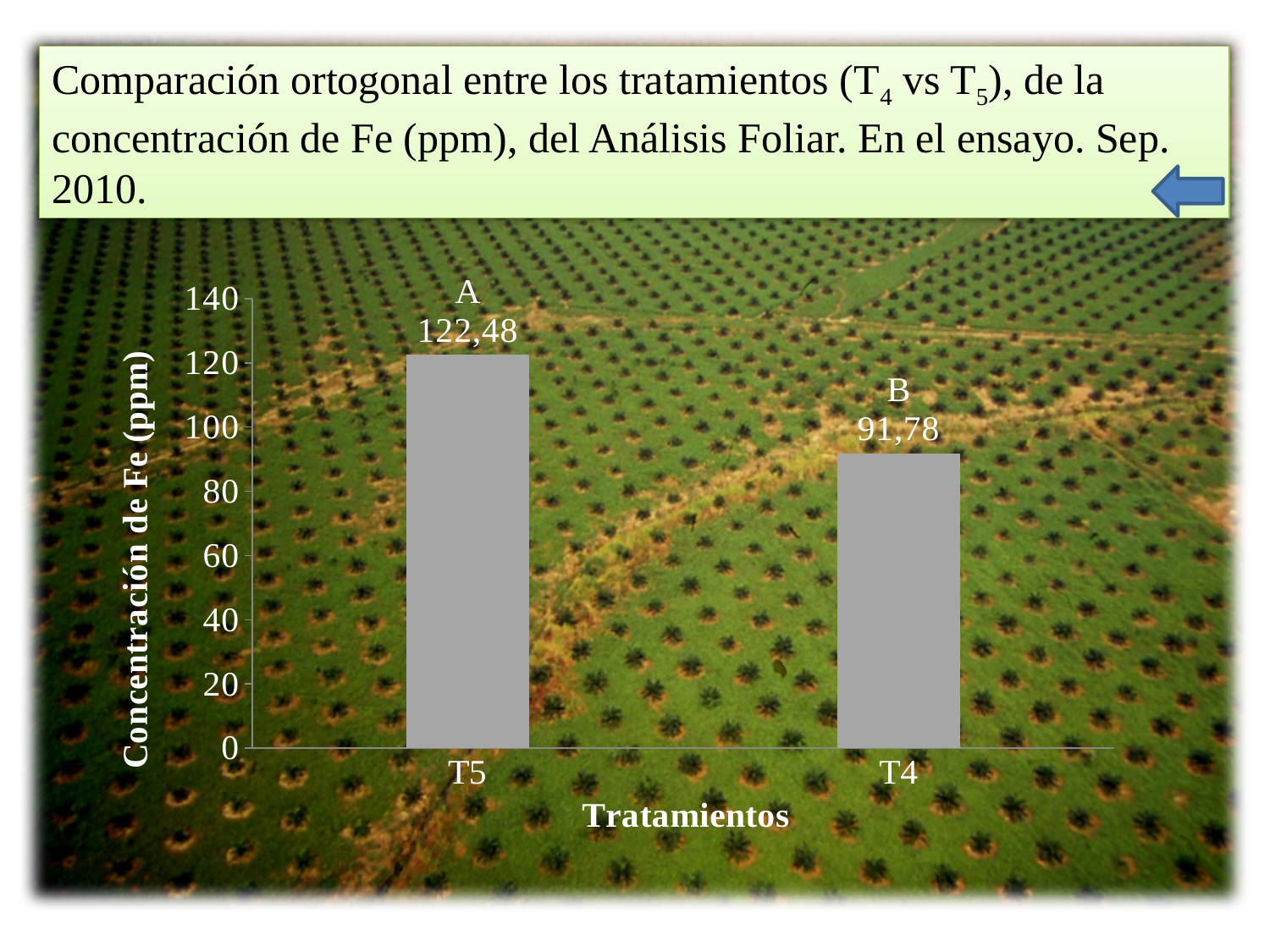
What is the difference in Fe concentration between T5 and T4? 30,70 What is the label of the y axis? Concentración de Fe (ppm) What kind of chart is shown on the slide? bar chart What statistical group letter is shown above the T4 bar? B Is the value for T5 greater or less than 120? greater What is the Fe concentration (ppm) for treatment T5? 122,48 Which treatment has the lowest Fe concentration? T4 How many treatments are shown on the x axis? 2 Which treatment has a larger Fe concentration, T4 or T5? T5 Is the value for T4 greater or less than 100? less What is the Fe concentration (ppm) for treatment T4? 91,78 Which treatment has the highest Fe concentration? T5